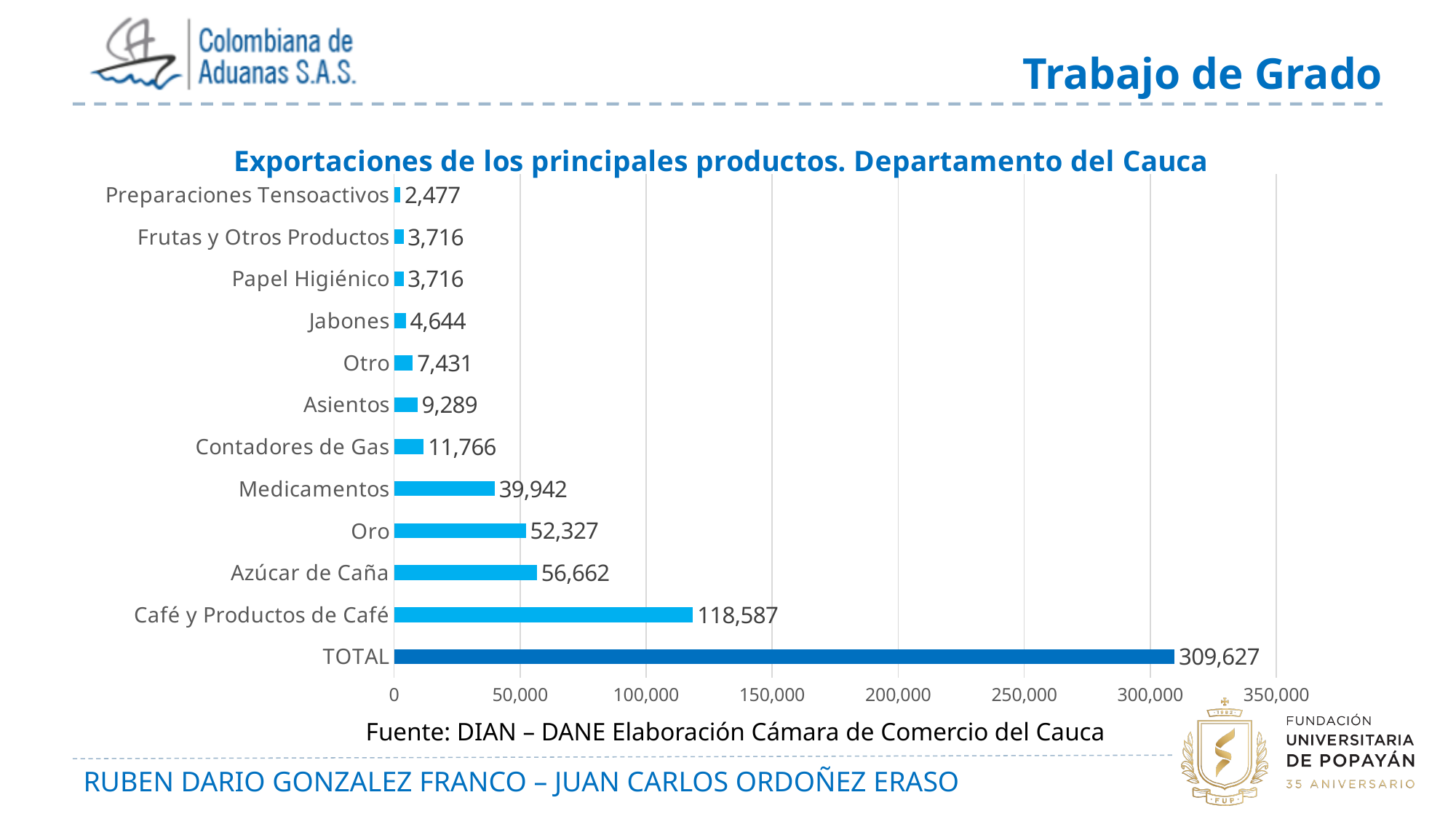
What type of chart is shown on the slide? Bar chart Excluding the TOTAL bar, which product has the highest export value? Café y Productos de Café What is the value shown for Contadores de Gas? 11,766 How many bars are plotted in the chart, including the TOTAL bar? 12 What is the value shown for Café y Productos de Café? 118,587 What is the value shown for Medicamentos? 39,942 What is the difference between the values for Azúcar de Caña and Oro? 4,335 What is the value of the TOTAL bar? 309,627 What is the difference between the TOTAL bar and the Café y Productos de Café bar? 191,040 Which is larger, the value for Asientos or the value for Otro? Asientos Is the value for Café y Productos de Café greater or less than 100,000? greater Which product has the lowest export value? Preparaciones Tensoactivos